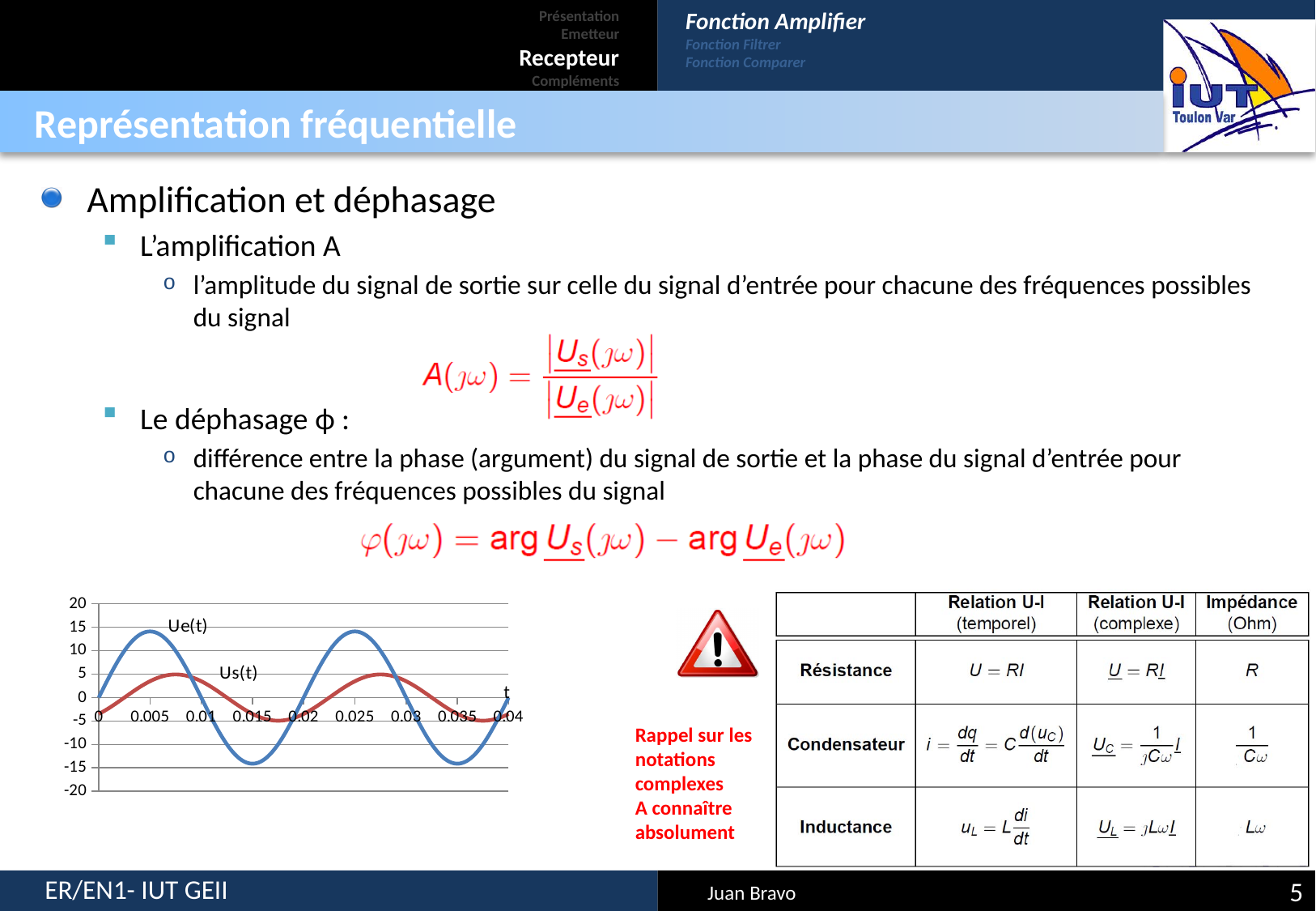
What is the last value shown on the horizontal axis of the chart? 0.04 What are the names of the two signals plotted on the chart? Ue(t) and Us(t) What kind of chart is shown at the bottom left of the slide? line chart Is the minimum value of Ue(t) on the chart greater or less than -10? less Is the peak value of Ue(t) on the chart greater or less than 20? less Is the peak value of Ue(t) on the chart greater or less than 10? greater What colour is the Us(t) line on the chart? red How many signals are plotted on the chart at the bottom left of the slide? 2 Which signal on the chart has the larger amplitude, Ue(t) or Us(t)? Ue(t) How many tick labels are shown on the horizontal axis of the chart? 9 What is the highest value shown on the vertical axis of the chart? 20